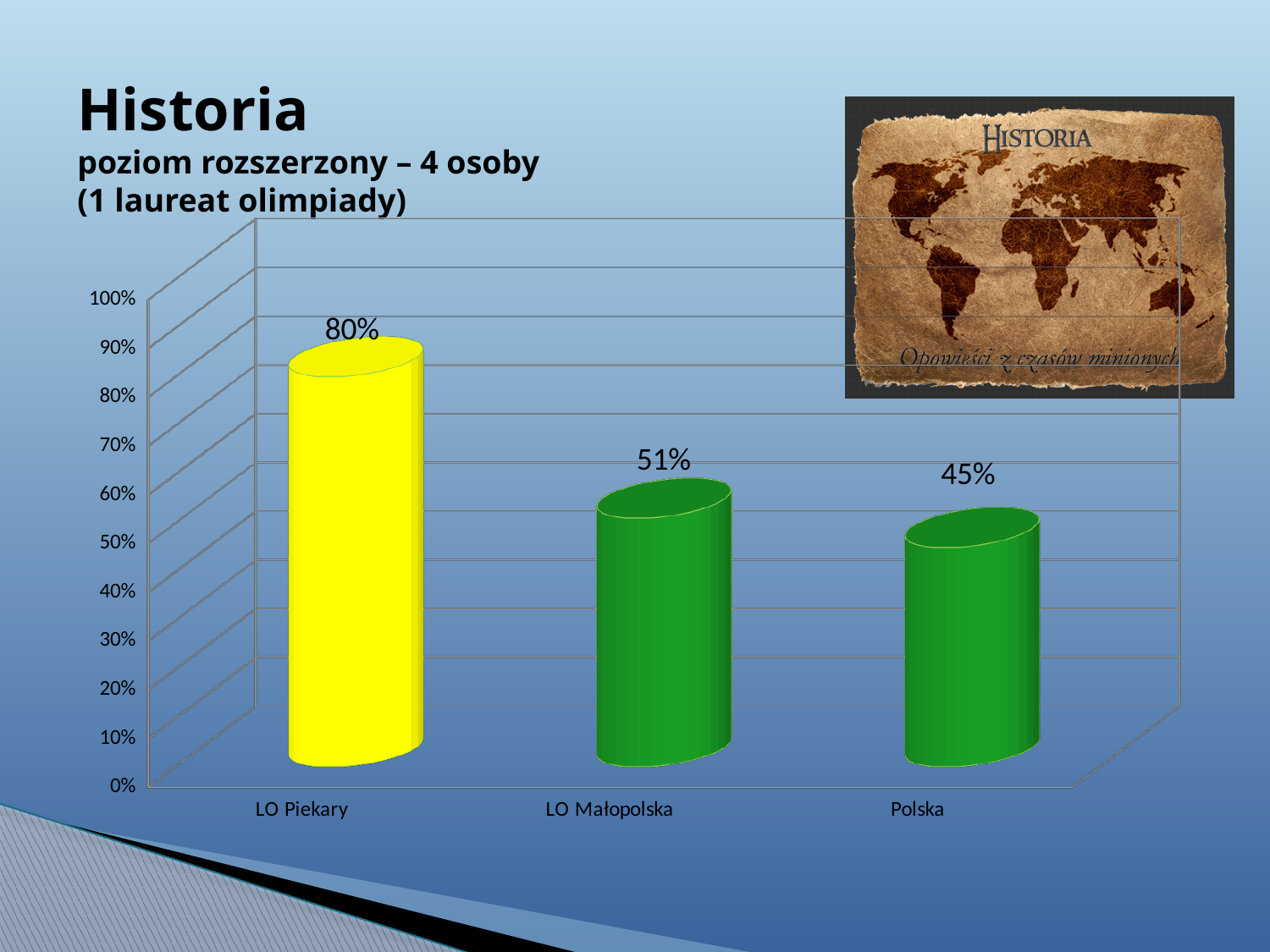
Which is larger, the value for LO Małopolska or the value for Polska? LO Małopolska What is the difference between the values for LO Małopolska and Polska? 6% What is the value for LO Małopolska? 51% What is the value for LO Piekary? 80% What kind of chart is shown on the slide? bar chart How many categories are shown on the chart? 3 What is the value for Polska? 45% Is the value for LO Piekary greater or less than 70%? greater What colour is the bar for LO Piekary? yellow What is the difference between the values for LO Piekary and Polska? 35% Which category has the lowest value? Polska Which category has the highest value? LO Piekary